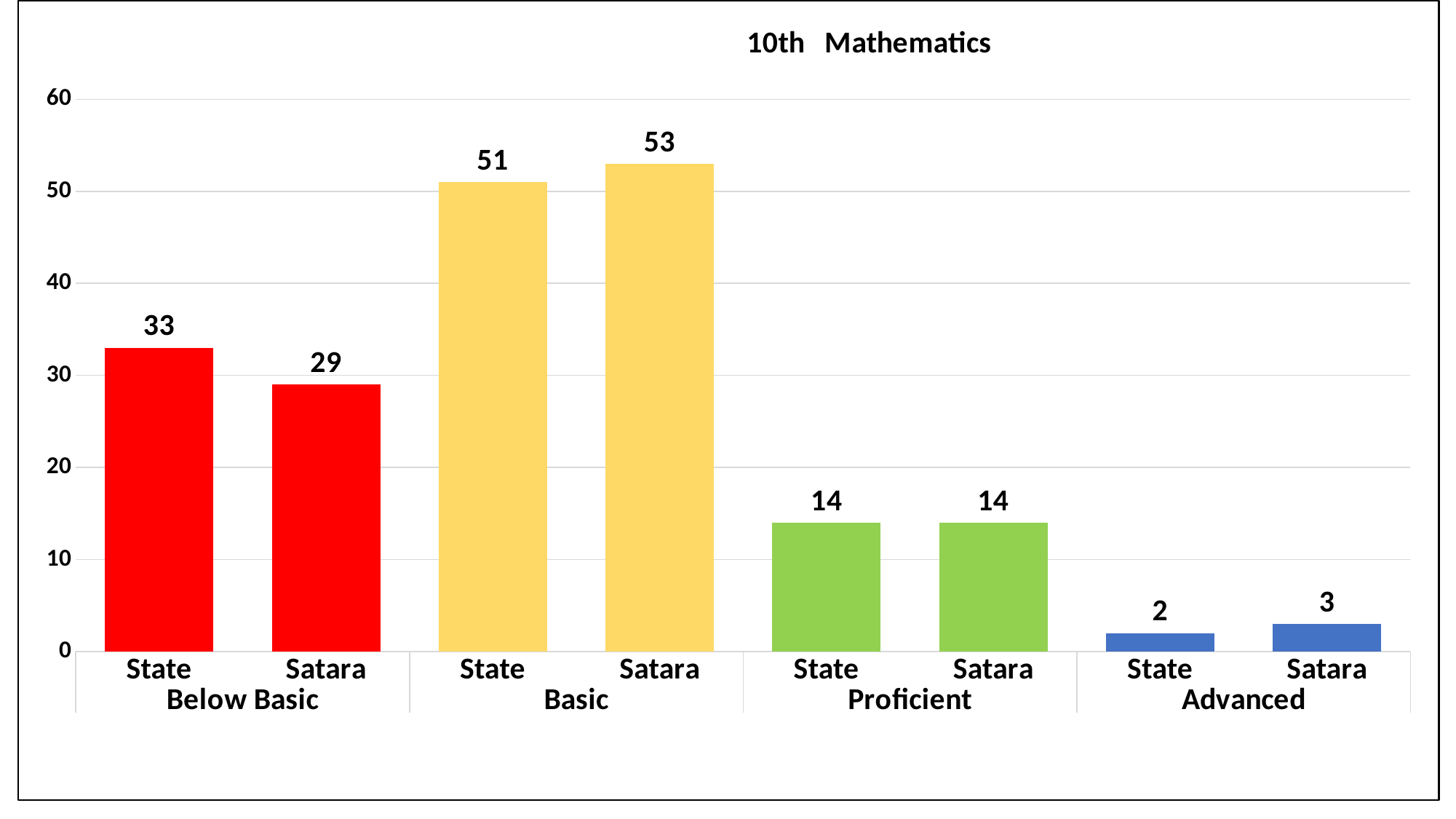
What is the difference between the State and Satara values in the Below Basic group? 4 How many bars are plotted on the chart? 8 Which bar has the highest value on the chart? Satara, Basic Which bar has the lowest value on the chart? State, Advanced What is the value for Satara in the Basic group? 53 What is the title of the chart? 10th Mathematics Which is larger in the Basic group, State or Satara? Satara How many performance level groups are shown on the x axis? 4 What is the value for State in the Below Basic group? 33 What is the value for Satara in the Advanced group? 3 Is the value for State in the Basic group greater or less than 40? greater What kind of chart is shown? bar chart